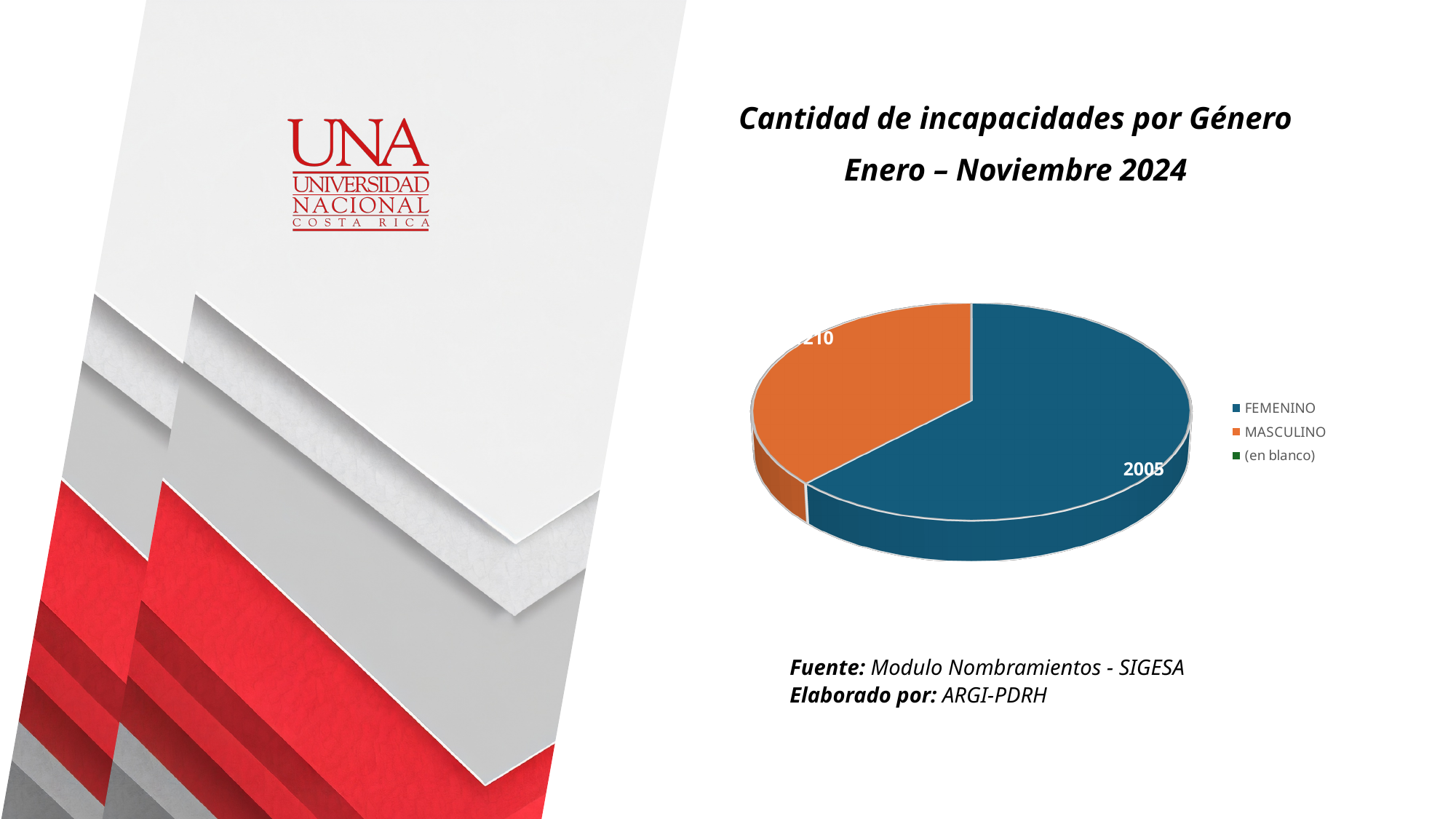
What is the value shown for FEMENINO in the pie chart? 2005 Which slice is larger, FEMENINO or MASCULINO? FEMENINO What is the title of the chart on the slide? Cantidad de incapacidades por Género Enero – Noviembre 2024 What colour is the FEMENINO slice in the pie chart? blue Which category has the largest slice of the pie chart? FEMENINO What kind of chart is shown on the slide? pie chart How many entries does the legend of the pie chart list? 3